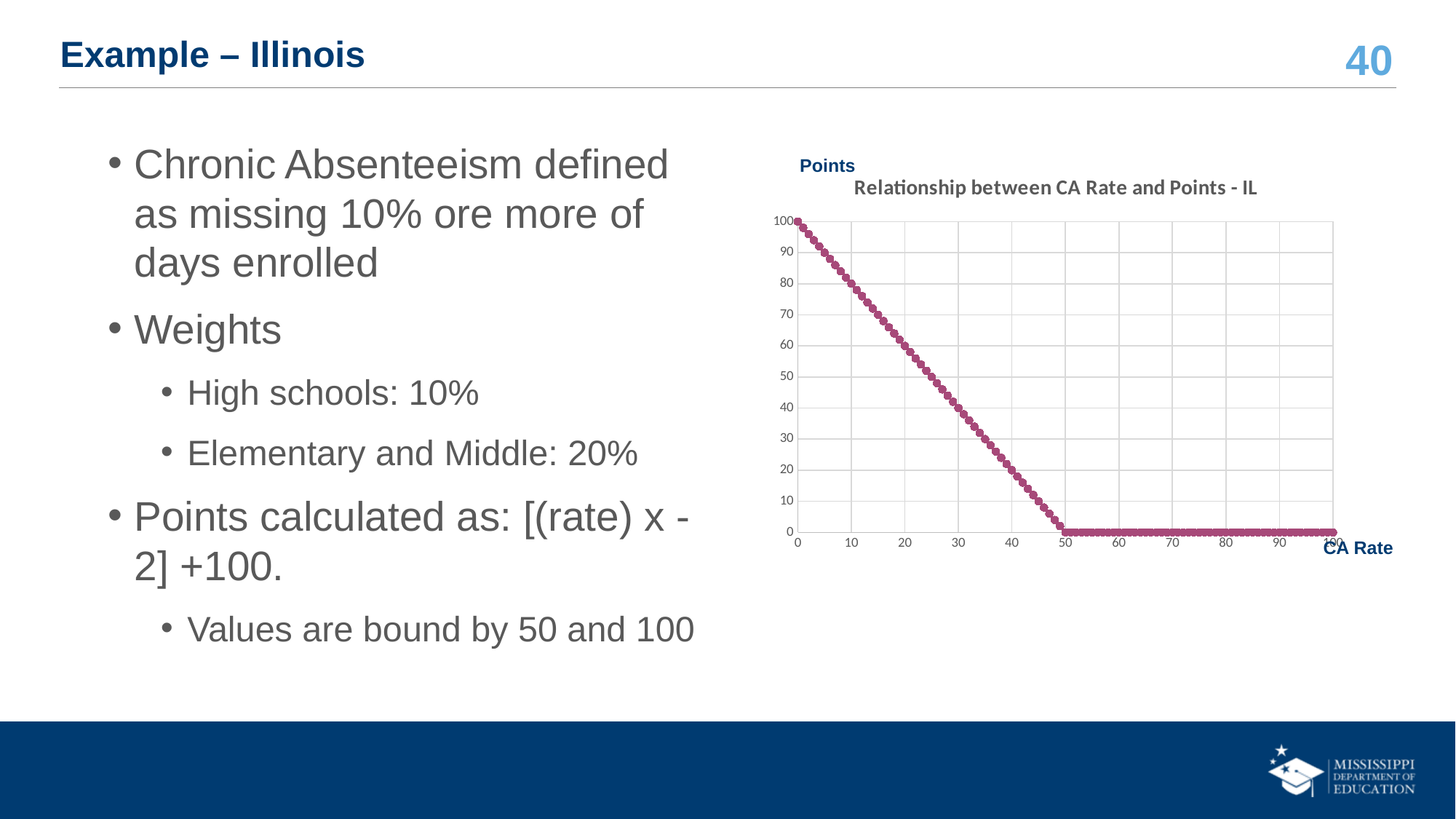
What is the Points value when the CA Rate is 10? 80 Is the Points value at a CA Rate of 40 greater or less than 30? less Which CA Rate has the highest Points value, 0 or 50? 0 What is the Points value when the CA Rate is 100? 0 What kind of chart is shown on the slide? scatter chart What is the difference in Points between a CA Rate of 0 and a CA Rate of 50? 100 Do the Points values rise or fall as the CA Rate increases from 0 to 50? fall What is the Points value when the CA Rate is 50? 0 What is the Points value when the CA Rate is 0? 100 Is the Points value at a CA Rate of 20 greater or less than 50? greater What is the title of the chart? Relationship between CA Rate and Points - IL What is the Points value when the CA Rate is 30? 40